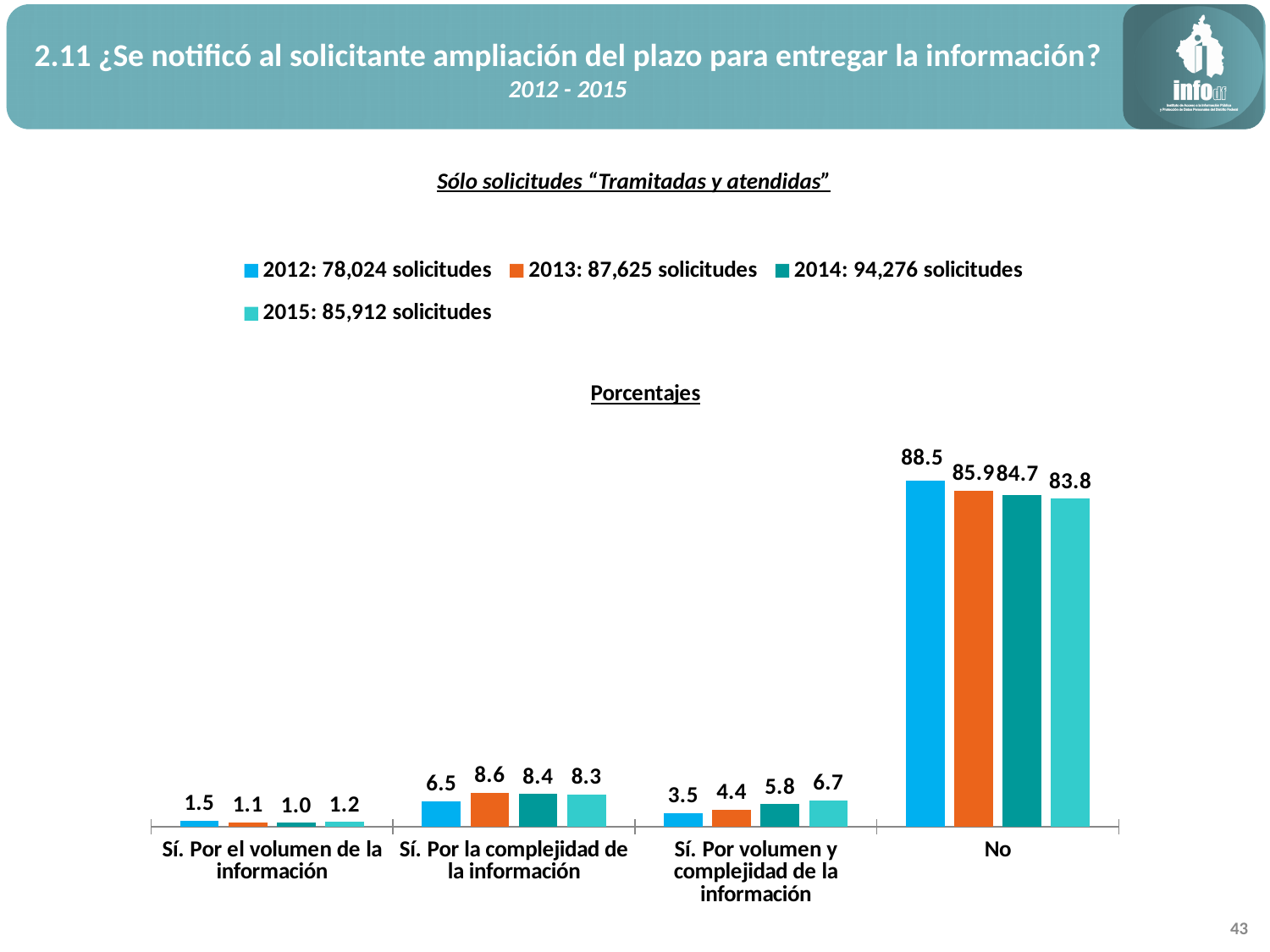
How many series does the legend list? 4 How many categories are shown on the x axis? 4 What is the value for "Sí. Por la complejidad de la información" in the 2013 series? 8.6 According to the legend, how many solicitudes were there in 2014? 94,276 What kind of chart is shown on the slide? bar chart What is the value for "No" in the 2012 series? 88.5 Which category has the lowest value in the 2012 series? Sí. Por el volumen de la información What is the value for "Sí. Por el volumen de la información" in the 2014 series? 1.0 Which is larger for "Sí. Por volumen y complejidad de la información": the 2013 value or the 2014 value? 2014 What is the value for "Sí. Por volumen y complejidad de la información" in the 2015 series? 6.7 What is the difference between the 2012 and 2015 values for "No"? 4.7 Which category has the highest value in the 2015 series? No